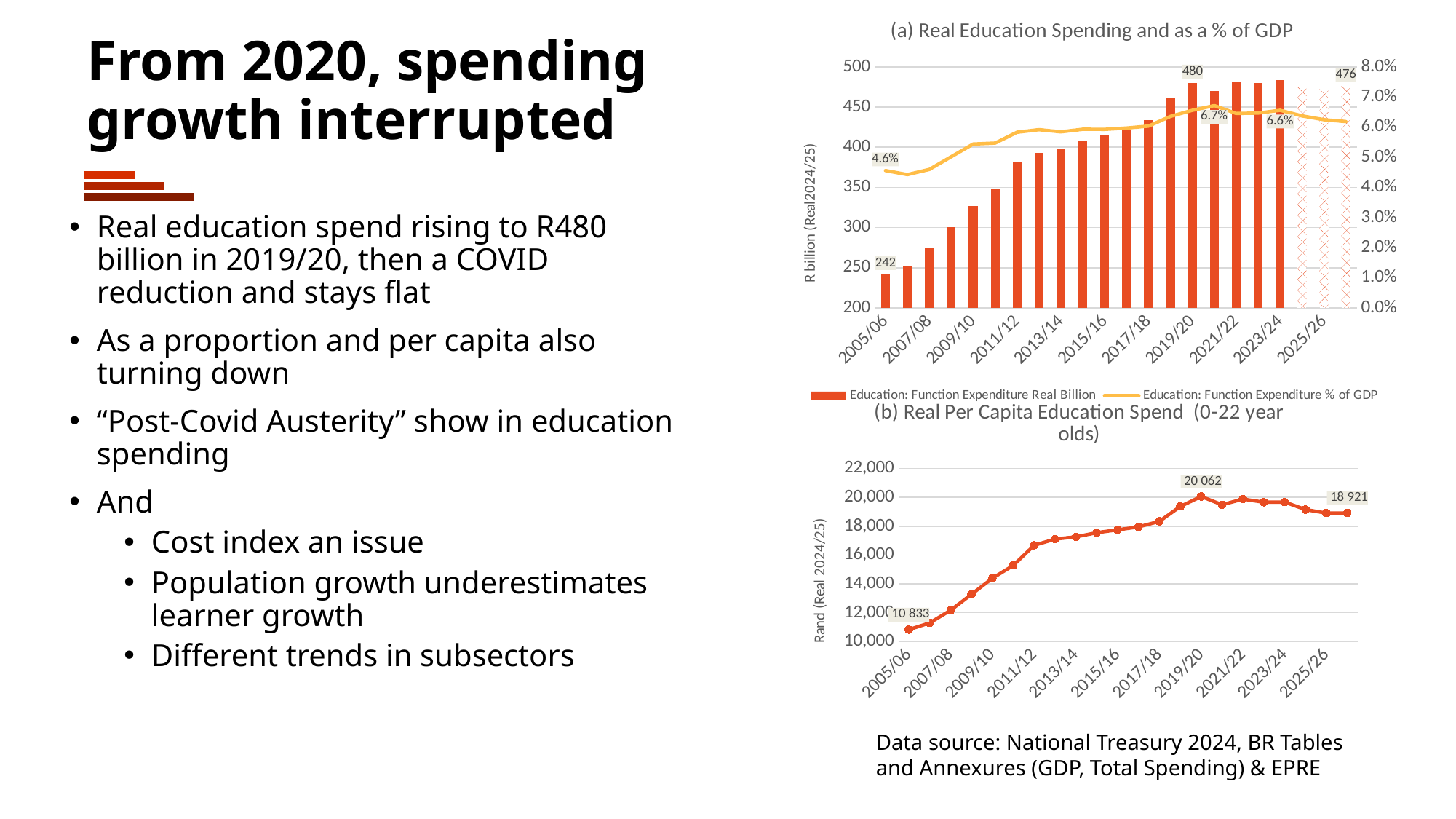
In chart (a), what is the real education spending value for 2005/06? 242 In chart (a), what is education spending as a % of GDP in 2005/06? 4.6% In chart (b), which year has the highest real per capita education spend? 2019/20 In chart (b), is the value for 2009/10 greater or less than 14,000? greater In chart (a), which is larger, the real spending bar for 2005/06 or for 2007/08? 2007/08 In chart (b), what is the real per capita education spend in 2005/06? 10 833 In chart (a), what is the real education spending value for 2019/20? 480 In chart (a), what is the difference between the real spending in 2019/20 and in 2005/06? 238 In chart (a), what is the data label on the final (hatched) bar? 476 What kind of chart is chart (b), Real Per Capita Education Spend? line chart In chart (a), how many series does the legend list? 2 In chart (a), is the real spending bar for 2009/10 greater or less than 350? less